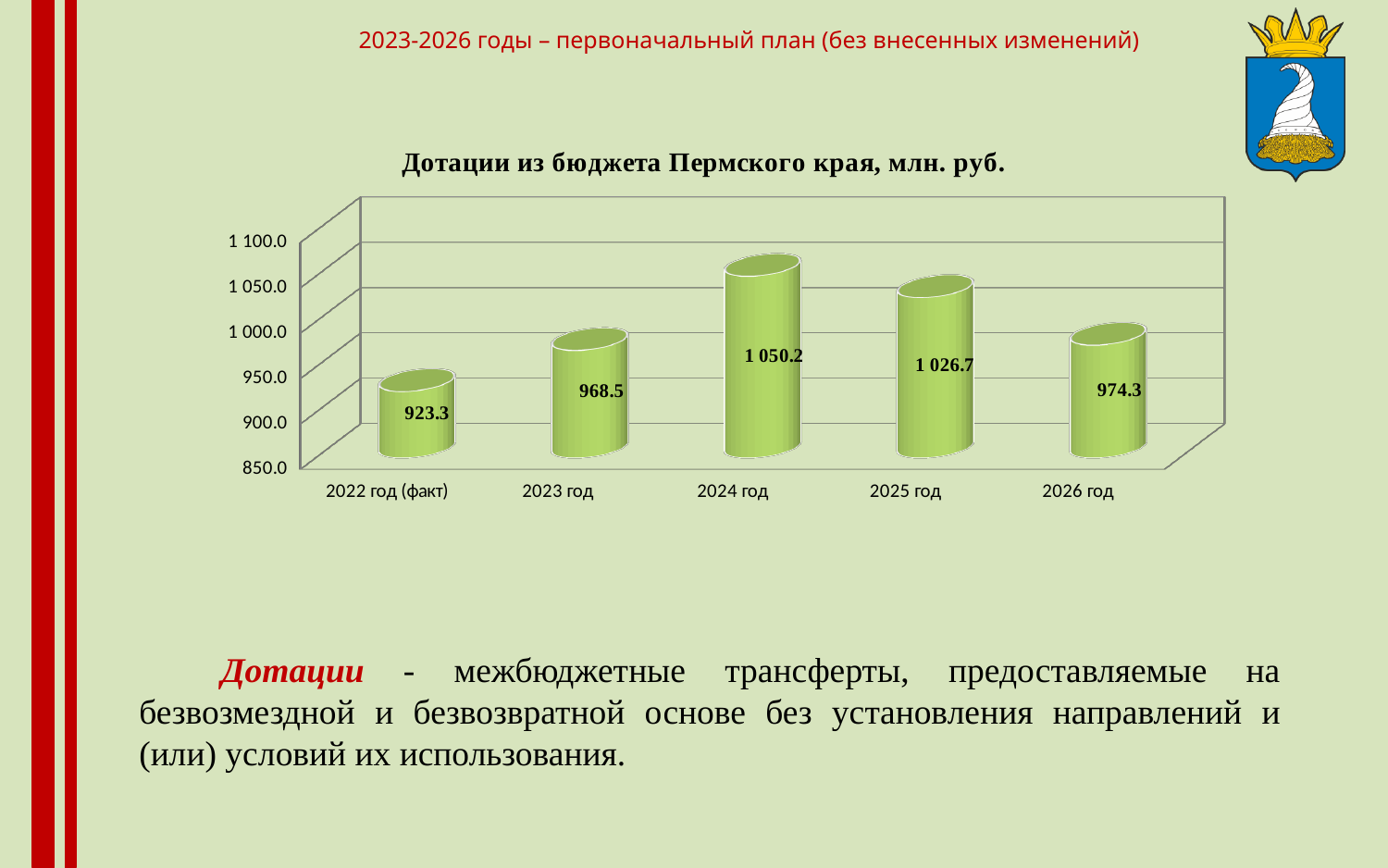
What is the difference between the values for 2024 год and 2025 год? 23.5 What is the value for 2024 год? 1 050.2 Which year has the lowest value? 2022 год (факт) Is the value for 2023 год greater or less than 1 000.0? less What is the difference between the values for 2023 год and 2022 год (факт)? 45.2 How many categories are shown on the x axis? 5 What kind of chart is shown? bar chart What is the value for 2026 год? 974.3 Which year has the highest value? 2024 год What is the title of the chart? Дотации из бюджета Пермского края, млн. руб. What is the value for 2022 год (факт)? 923.3 Which is larger, the value for 2025 год or the value for 2026 год? 2025 год